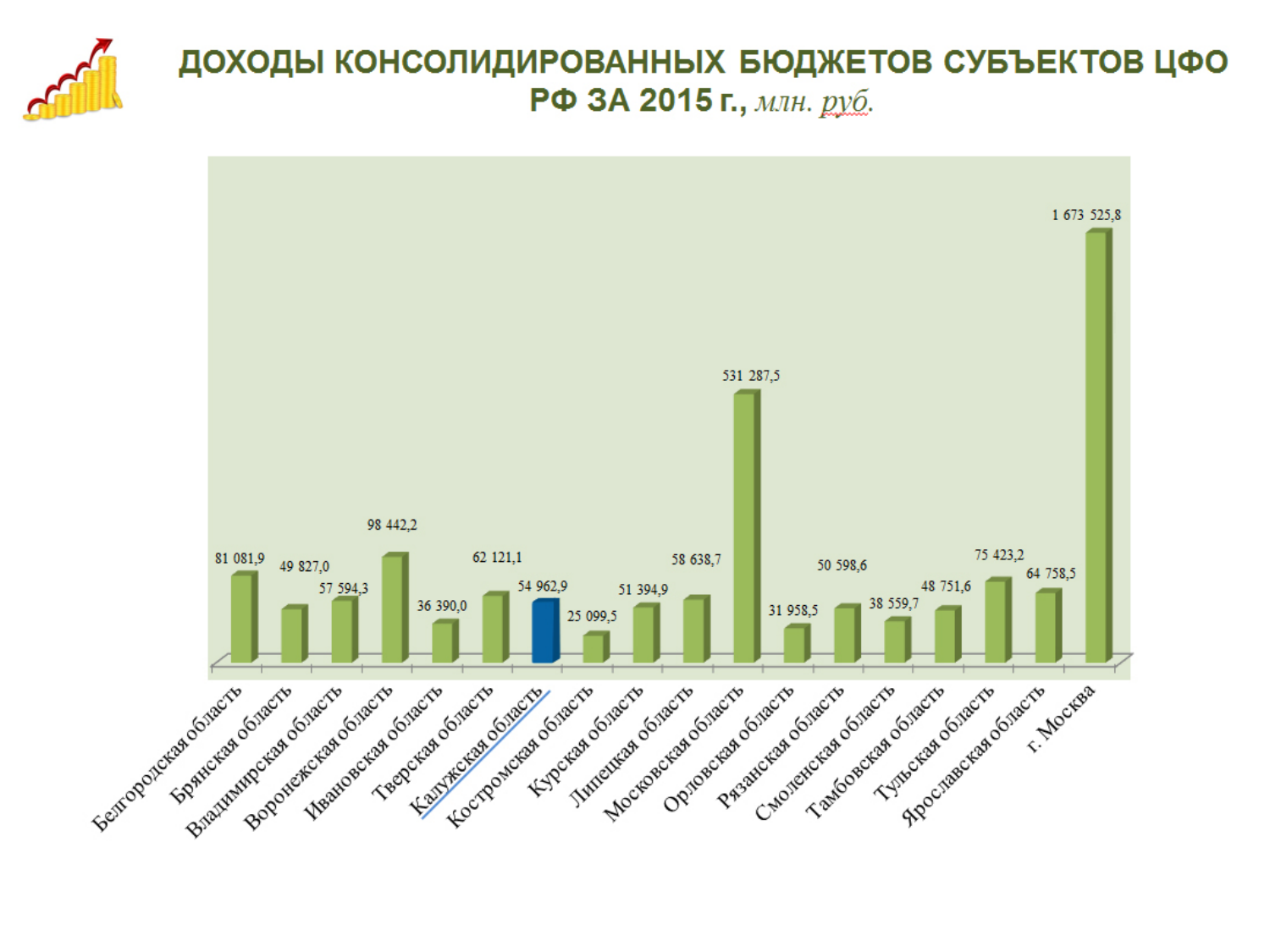
What is the value for Московская область? 531 287,5 What is the difference between the values for г. Москва and Московская область? 1 142 238,3 What kind of chart is shown on the slide? Bar chart Which category has the highest value? г. Москва What is the value for Калужская область? 54 962,9 How many categories are shown on the chart? 18 Which category has the lowest value? Костромская область What is the value for Тульская область? 75 423,2 Which category's bar is coloured blue instead of green? Калужская область What is the difference between the values for Воронежская область and Белгородская область? 17 360,3 What is the value for Ивановская область? 36 390,0 Which is larger, the value for Тверская область or the value for Липецкая область? Тверская область